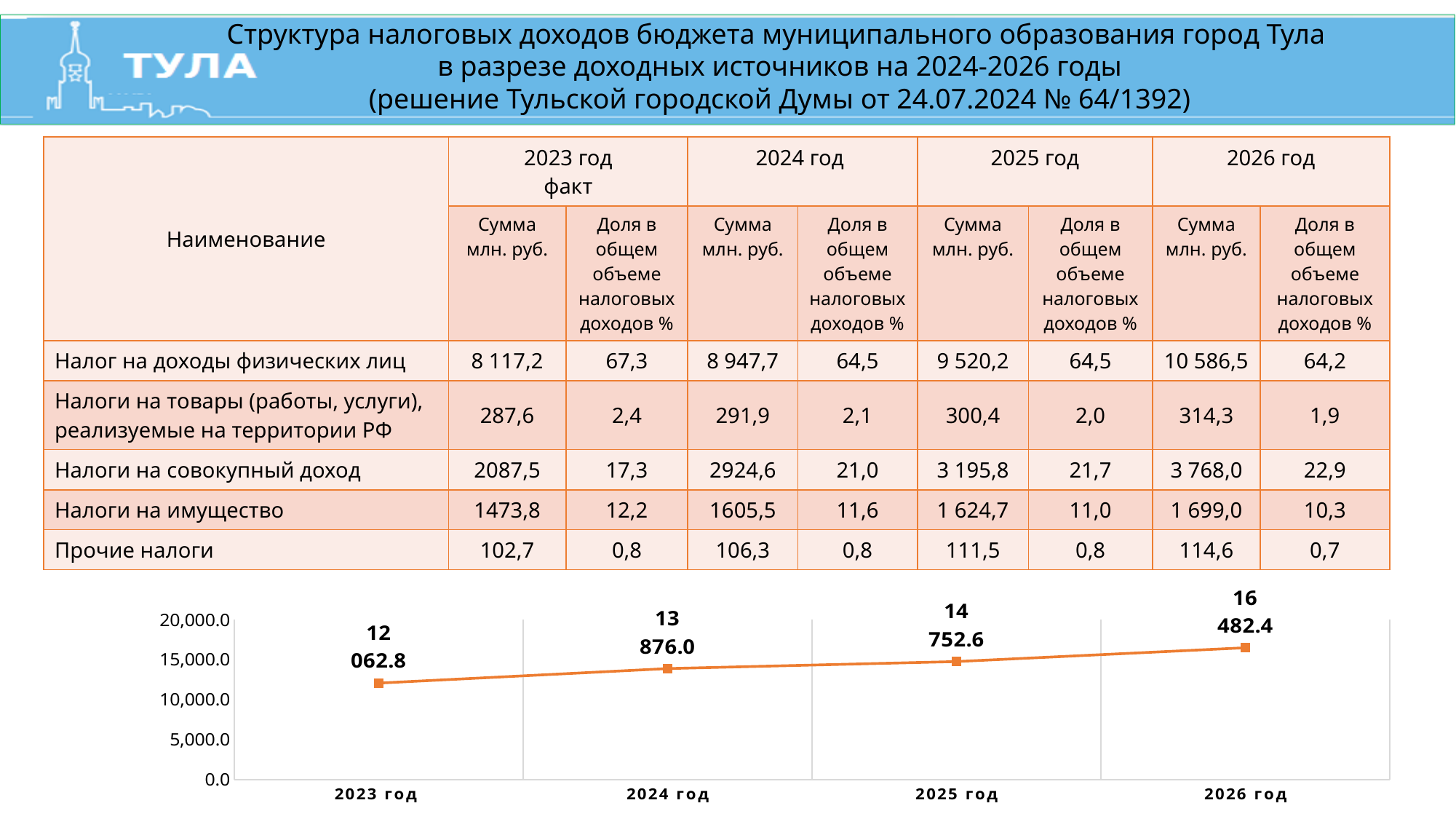
How many data points are plotted in the line chart? 4 What kind of chart is shown below the table on the slide? line chart In the line chart, which year has the lowest value? 2023 год In the line chart, what is the value for 2026 год? 16 482.4 In the line chart, what is the value for 2024 год? 13 876.0 Do the values in the line chart rise or fall from 2023 год to 2026 год? rise In the line chart, which year has the highest value? 2026 год In the line chart, which is larger: the value for 2025 год or the value for 2024 год? 2025 год In the line chart, what is the value for 2023 год? 12 062.8 In the line chart, what is the value for 2025 год? 14 752.6 In the line chart, is the value for 2023 год greater or less than 15,000.0? less In the line chart, what is the difference between the values for 2026 год and 2023 год? 4 419.6